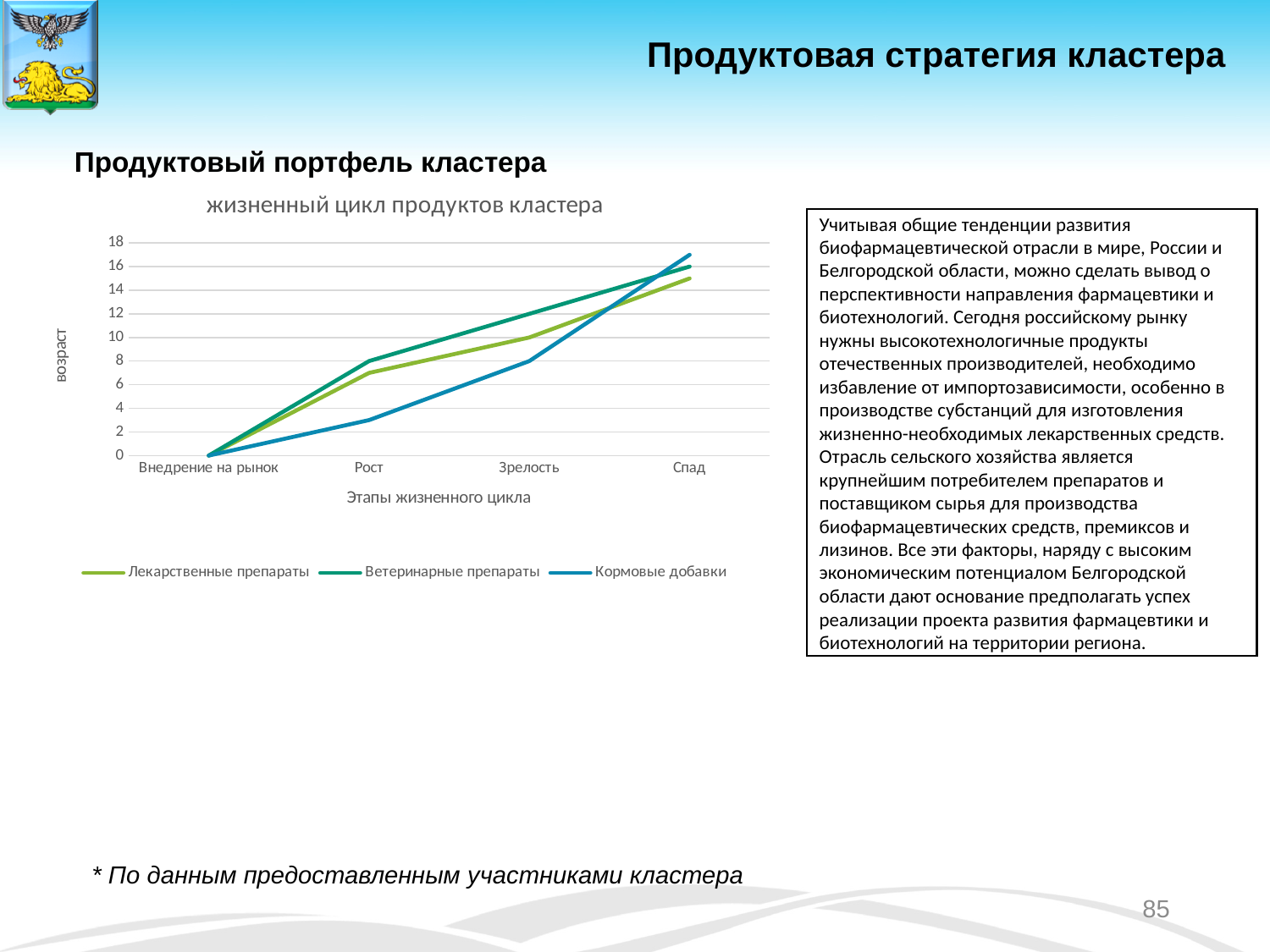
Which series has the highest value at the Спад stage? Кормовые добавки What is the title of the chart? жизненный цикл продуктов кластера Do the values for Лекарственные препараты rise or fall from Внедрение на рынок to Спад? rise Is the value for Ветеринарные препараты at Зрелость greater or less than 10? greater What kind of chart is shown on the slide? line chart Is the value for Кормовые добавки at Рост greater or less than 4? less How many stages are shown along the x axis of the chart? 4 How many series does the chart legend list? 3 What is the label of the vertical axis of the chart? возраст What is the value for Кормовые добавки at Внедрение на рынок? 0 At the Зрелость stage, which is larger: Ветеринарные препараты or Кормовые добавки? Ветеринарные препараты Which series has the lowest value at the Рост stage? Кормовые добавки